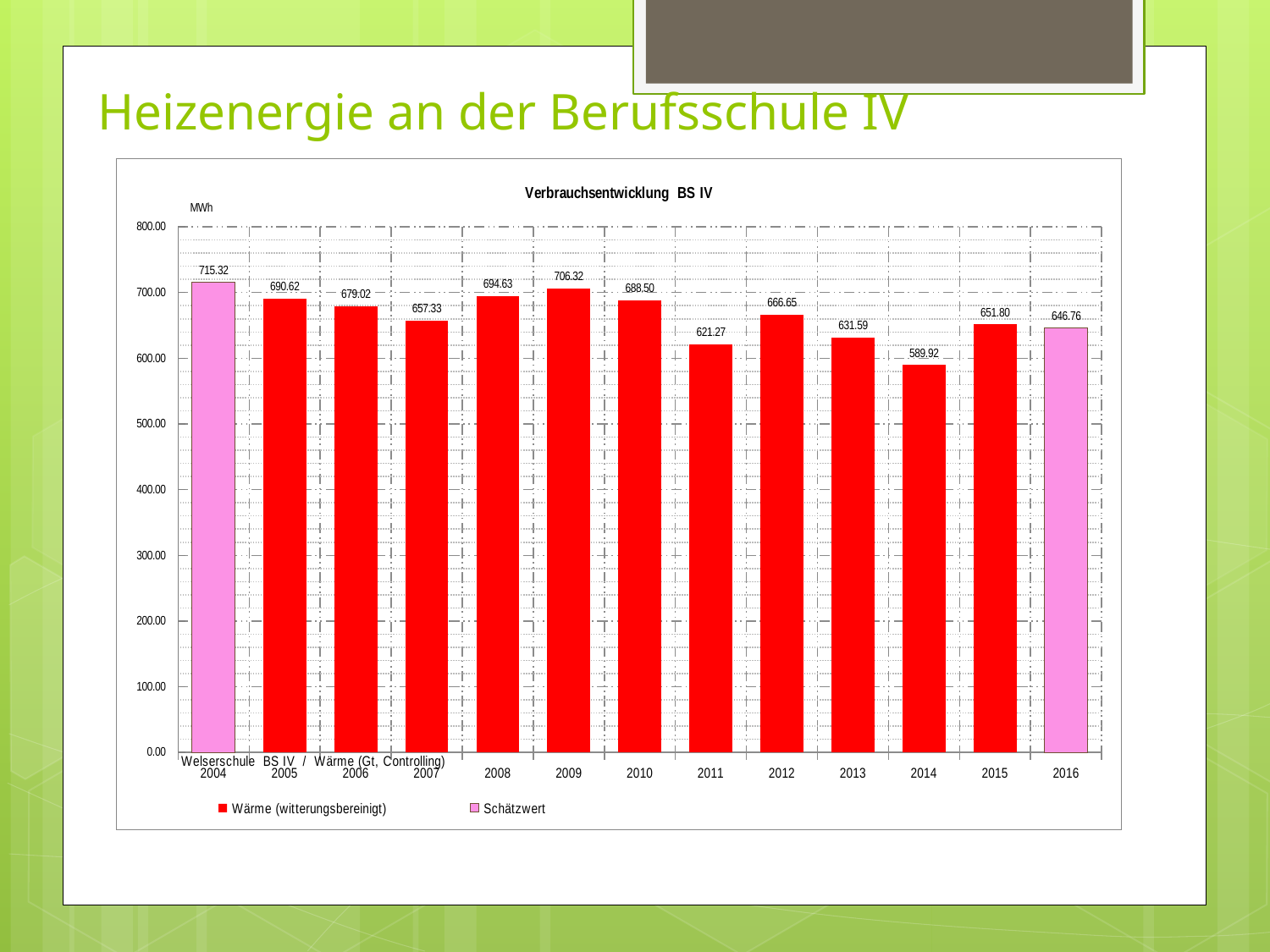
What is the value for 2009 in the Verbrauchsentwicklung BS IV chart? 706.32 Which is larger, the value for 2012 or the value for 2013? 2012 What kind of chart is shown on the slide? bar chart Which year has the lowest value in the chart? 2014 What is the value for 2014 in the chart? 589.92 What is the difference between the values for 2004 and 2016? 68.56 What is the value for 2016 in the chart? 646.76 Is the value for 2011 greater or less than 600.00? greater How many years are shown on the x axis of the chart? 13 How many series does the legend list? 2 Which year has the highest value in the chart? 2004 What is the difference between the values for 2009 and 2011? 85.05